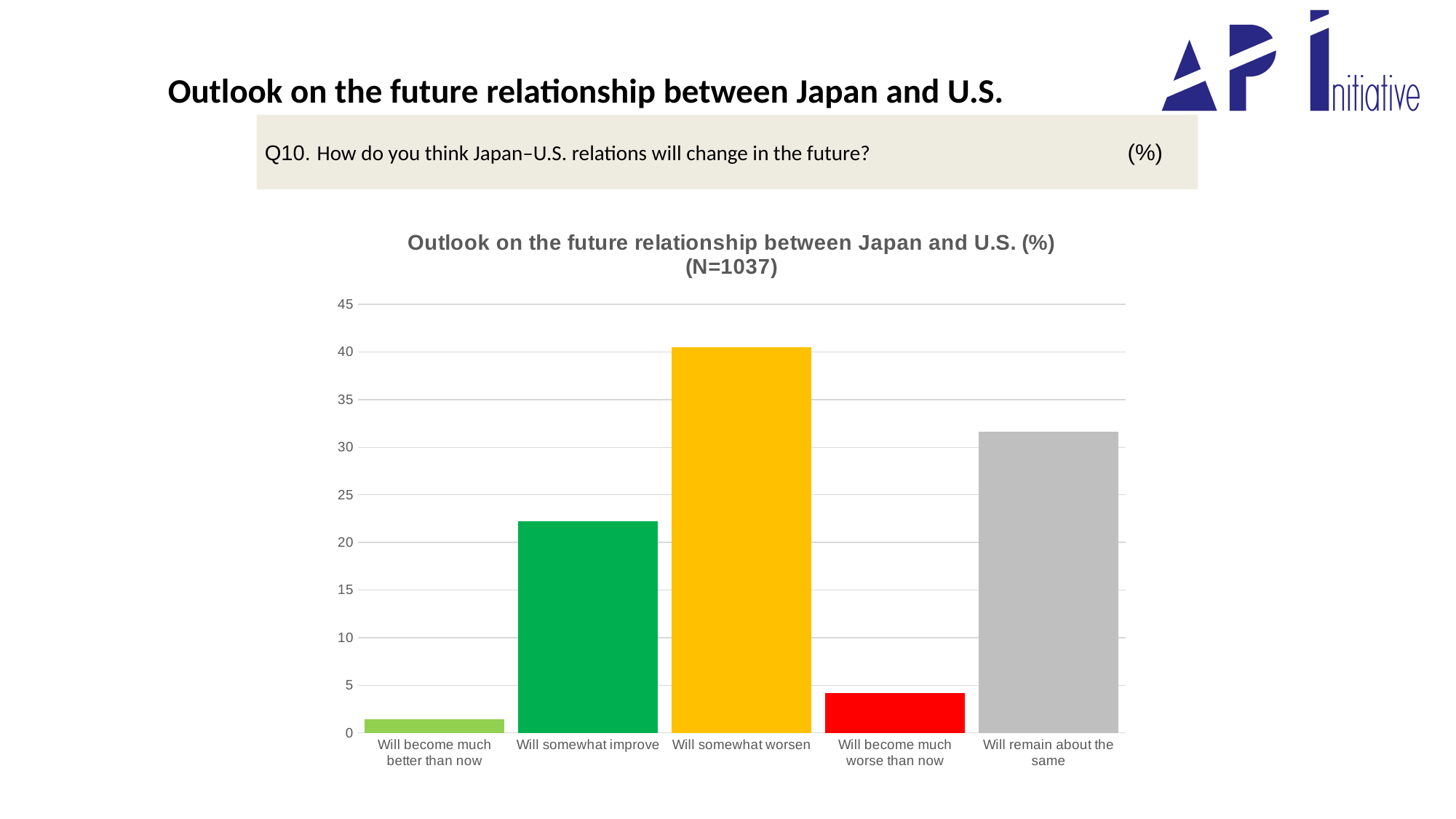
How many categories are shown on the x axis of the chart? 5 Is the value for "Will somewhat worsen" greater or less than 35? greater Which is larger, the value for "Will somewhat improve" or the value for "Will remain about the same"? Will remain about the same What kind of chart is shown on the slide? bar chart Which category has the highest value in the chart? Will somewhat worsen Is the value for "Will remain about the same" greater or less than 30? greater What sample size (N) is stated in the chart title? N=1037 Is the value for "Will become much worse than now" greater or less than 5? less Which is larger, the value for "Will become much worse than now" or the value for "Will become much better than now"? Will become much worse than now Which category has the lowest value in the chart? Will become much better than now